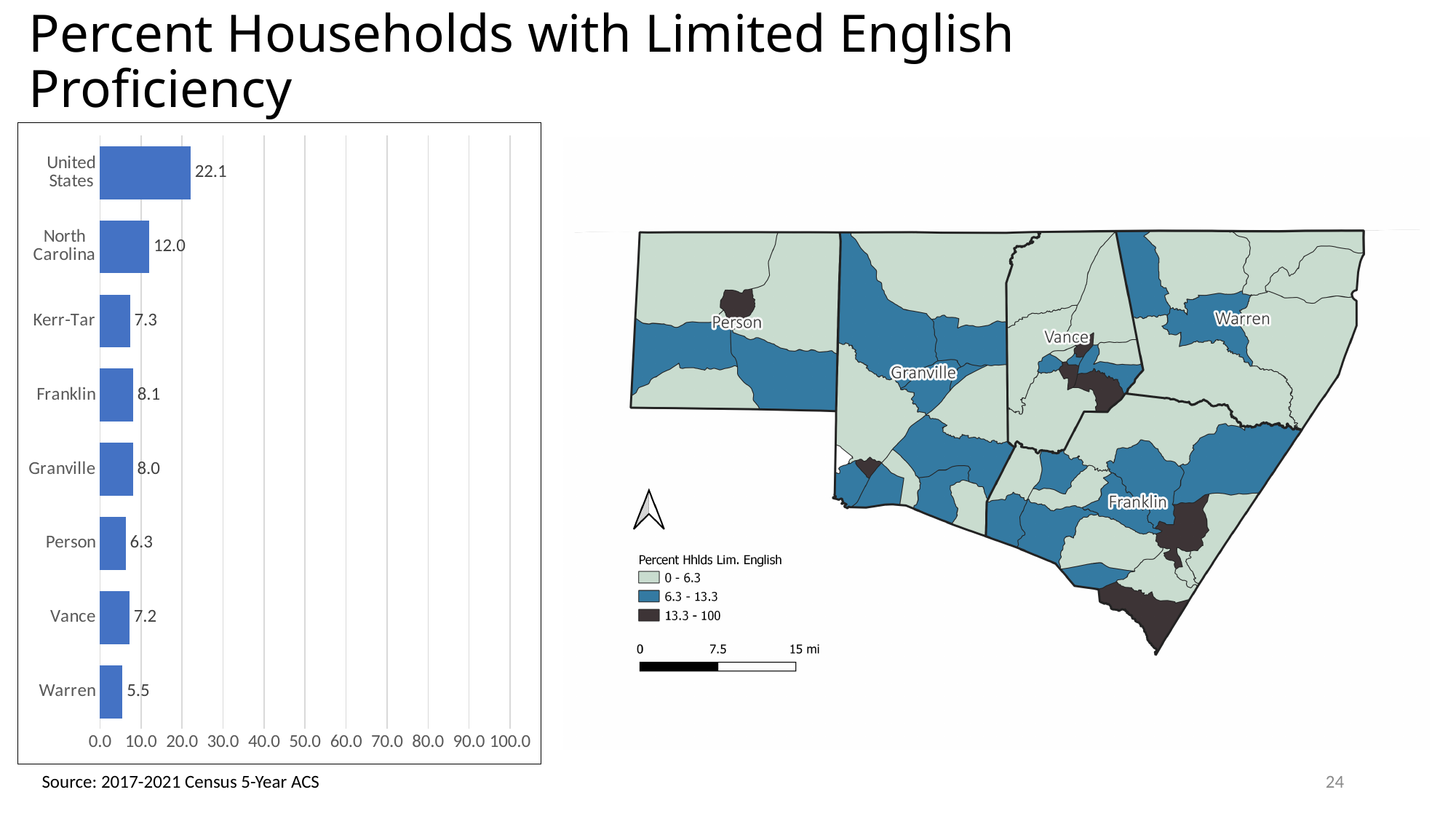
What is the maximum value shown on the x axis of the bar chart? 100.0 What is the value for Granville in the bar chart? 8.0 Is the value for United States in the bar chart greater or less than 20.0? greater How many categories are shown in the bar chart? 8 What kind of chart is shown on the left of the slide? bar chart Which has a larger value in the bar chart, Kerr-Tar or Person? Kerr-Tar What is the value for North Carolina in the bar chart? 12.0 Which category has the highest value in the bar chart? United States What is the value for Warren in the bar chart? 5.5 What is the difference between the United States and North Carolina values in the bar chart? 10.1 What is the difference between the Franklin and Person values in the bar chart? 1.8 Which category has the lowest value in the bar chart? Warren